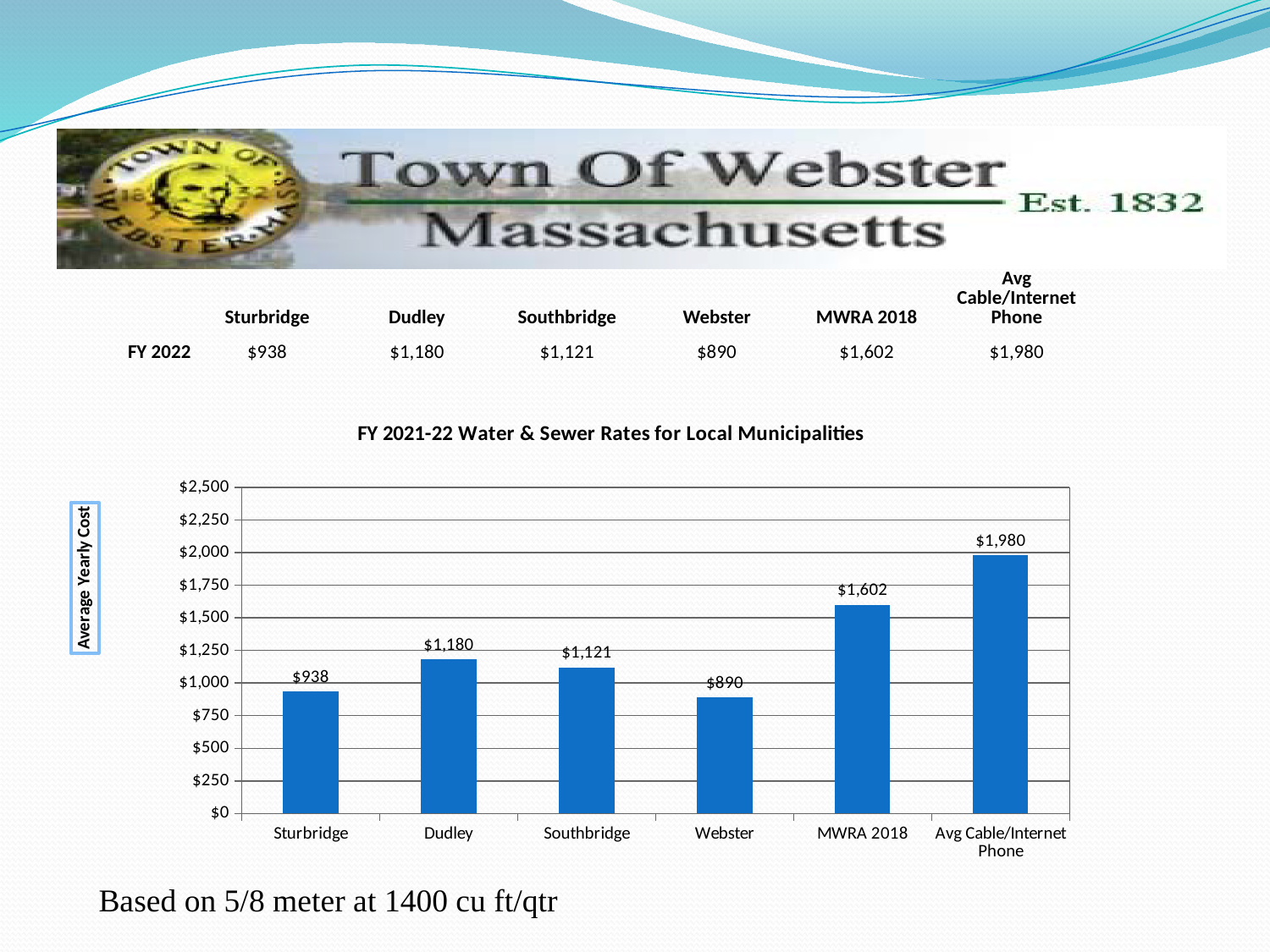
What is the average yearly cost for Webster? $890 What is the title of the chart? FY 2021-22 Water & Sewer Rates for Local Municipalities What is the difference between the Dudley and Sturbridge values? $242 What is the average yearly cost for MWRA 2018? $1,602 Is the value for Sturbridge greater or less than $1,000? less How many bars are shown in the chart? 6 Which category has the highest average yearly cost? Avg Cable/Internet Phone What type of chart is shown on the slide? bar chart Which is larger, the value for Dudley or the value for Southbridge? Dudley What is the value shown for Southbridge? $1,121 How much higher is the Avg Cable/Internet Phone value than the MWRA 2018 value? $378 Which municipality has the lowest average yearly cost? Webster